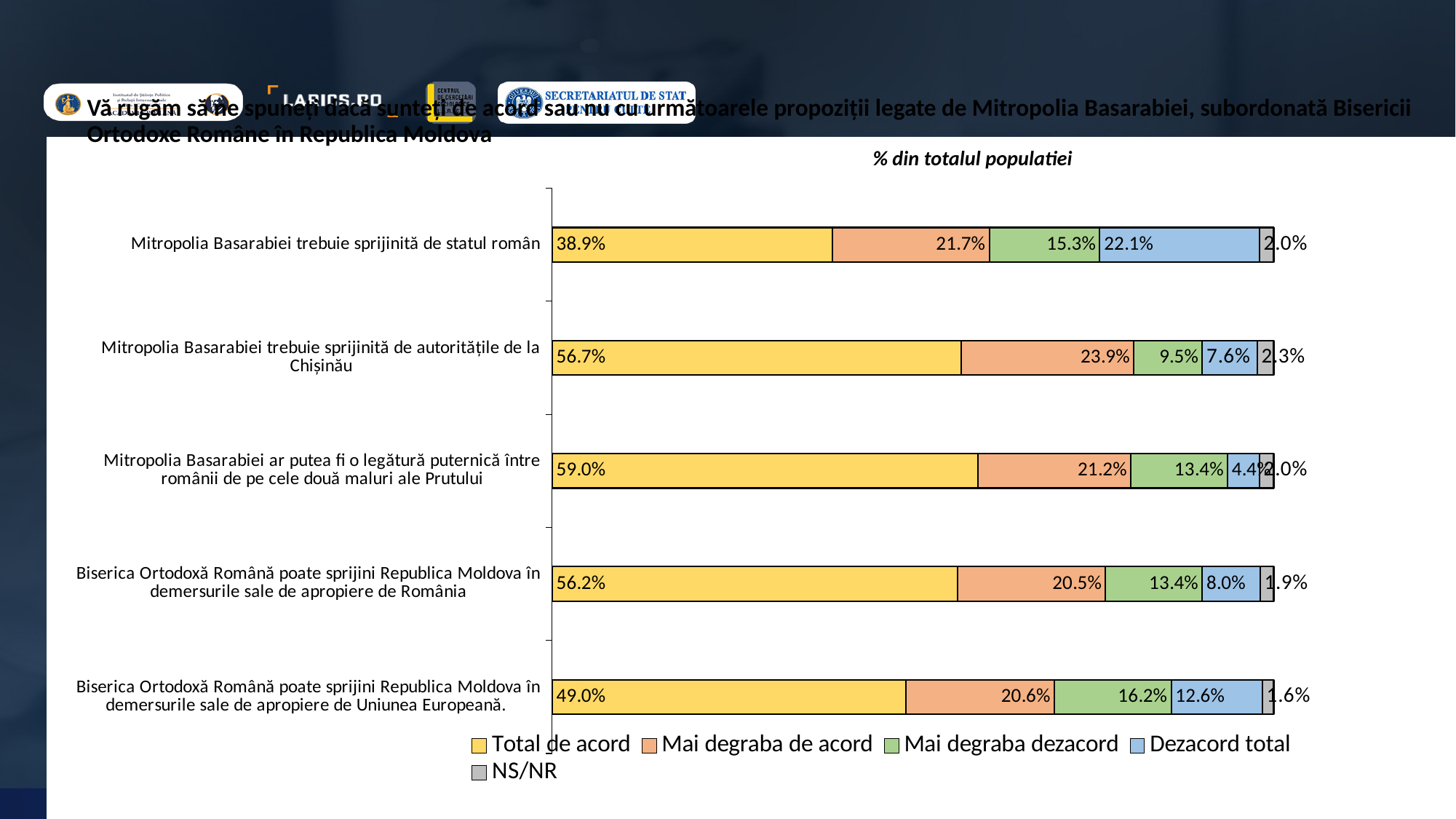
What is the 'Dezacord total' value for 'Mitropolia Basarabiei trebuie sprijinită de autoritățile de la Chișinău'? 7.6% What is the difference between the 'Total de acord' values for 'Mitropolia Basarabiei trebuie sprijinită de autoritățile de la Chișinău' and 'Mitropolia Basarabiei trebuie sprijinită de statul român'? 17.8% What is the total of the stacked bar for 'Mitropolia Basarabiei ar putea fi o legătură puternică între românii de pe cele două maluri ale Prutului'? 100.0% What is the 'Mai degraba dezacord' value for 'Biserica Ortodoxă Română poate sprijini Republica Moldova în demersurile sale de apropiere de Uniunea Europeană'? 16.2% Which statement has the highest 'Total de acord' share? Mitropolia Basarabiei ar putea fi o legătură puternică între românii de pe cele două maluri ale Prutului What is the NS/NR value for 'Biserica Ortodoxă Română poate sprijini Republica Moldova în demersurile sale de apropiere de România'? 1.9% Which is larger: the 'Dezacord total' value for 'Mitropolia Basarabiei trebuie sprijinită de statul român' or for 'Biserica Ortodoxă Română poate sprijini Republica Moldova în demersurile sale de apropiere de Uniunea Europeană'? Mitropolia Basarabiei trebuie sprijinită de statul român What percentage of respondents are 'Total de acord' that Mitropolia Basarabiei trebuie sprijinită de statul român? 38.9% What kind of chart is shown on the slide? Stacked bar chart How many statements (categories) are shown in the chart? 5 Which statement has the lowest 'Total de acord' share? Mitropolia Basarabiei trebuie sprijinită de statul român How many series does the legend list? 5